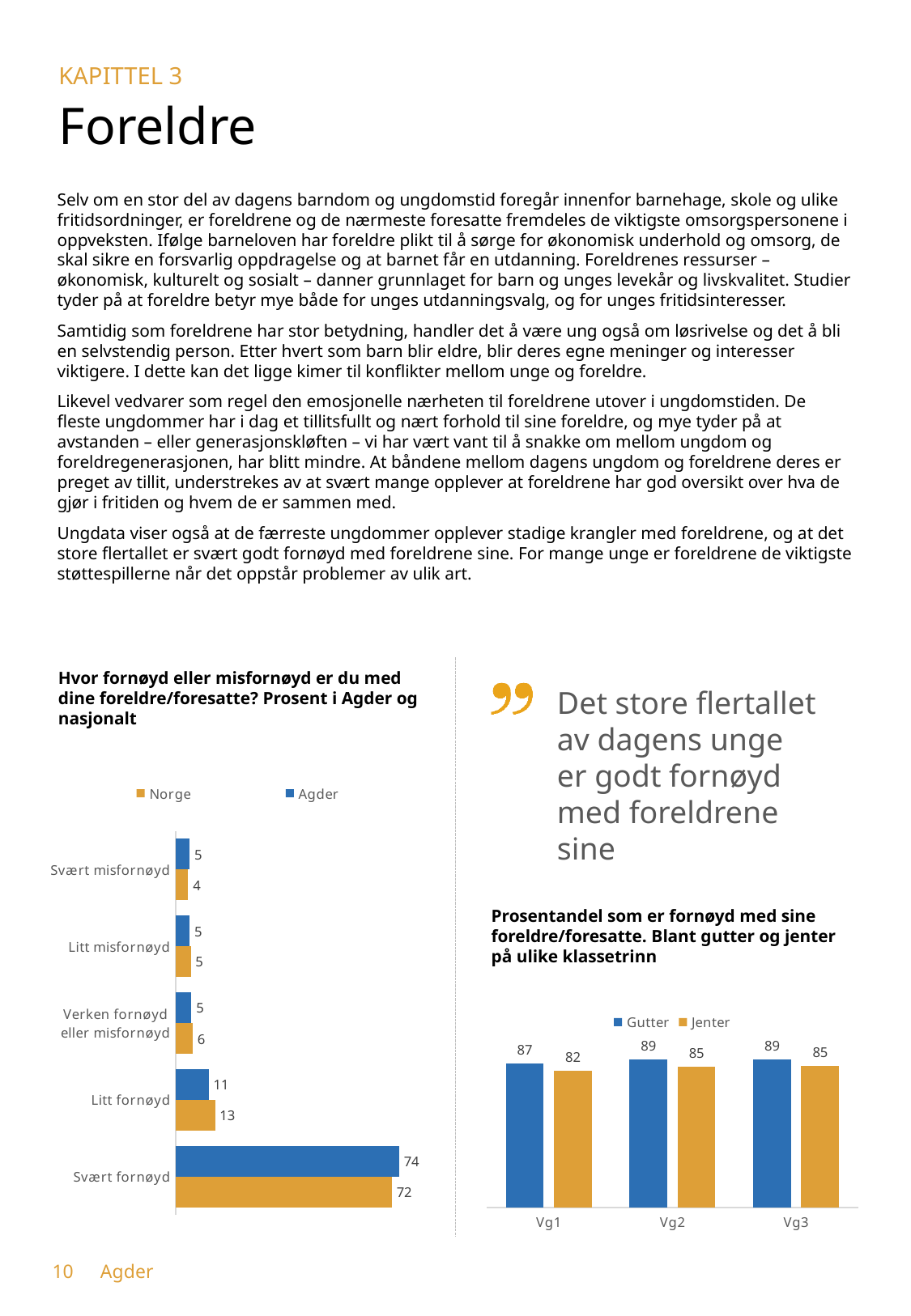
In the right chart (Prosentandel som er fornøyd med sine foreldre/foresatte), what is the Gutter value for Vg2? 89 In the left chart (Hvor fornøyd eller misfornøyd er du med dine foreldre/foresatte?), how many categories are shown? 5 In the left chart (Hvor fornøyd eller misfornøyd er du med dine foreldre/foresatte?), what is the Norge value for Litt fornøyd? 13 In the right chart (Prosentandel som er fornøyd med sine foreldre/foresatte), what is the Jenter value for Vg1? 82 In the right chart (Prosentandel som er fornøyd med sine foreldre/foresatte), which is larger for Vg3: Gutter or Jenter? Gutter In the left chart (Hvor fornøyd eller misfornøyd er du med dine foreldre/foresatte?), what is the Agder value for Svært fornøyd? 74 In the left chart (Hvor fornøyd eller misfornøyd er du med dine foreldre/foresatte?), which category has the highest Norge value? Svært fornøyd What kind of chart is the left chart (Hvor fornøyd eller misfornøyd er du med dine foreldre/foresatte?)? Bar chart In the right chart (Prosentandel som er fornøyd med sine foreldre/foresatte), which colour represents Jenter? Orange In the left chart (Hvor fornøyd eller misfornøyd er du med dine foreldre/foresatte?), what is the difference between the Agder and Norge values for Svært fornøyd? 2 In the right chart (Prosentandel som er fornøyd med sine foreldre/foresatte), what is the difference between Gutter and Jenter for Vg1? 5 In the left chart (Hvor fornøyd eller misfornøyd er du med dine foreldre/foresatte?), how many series does the legend list? 2